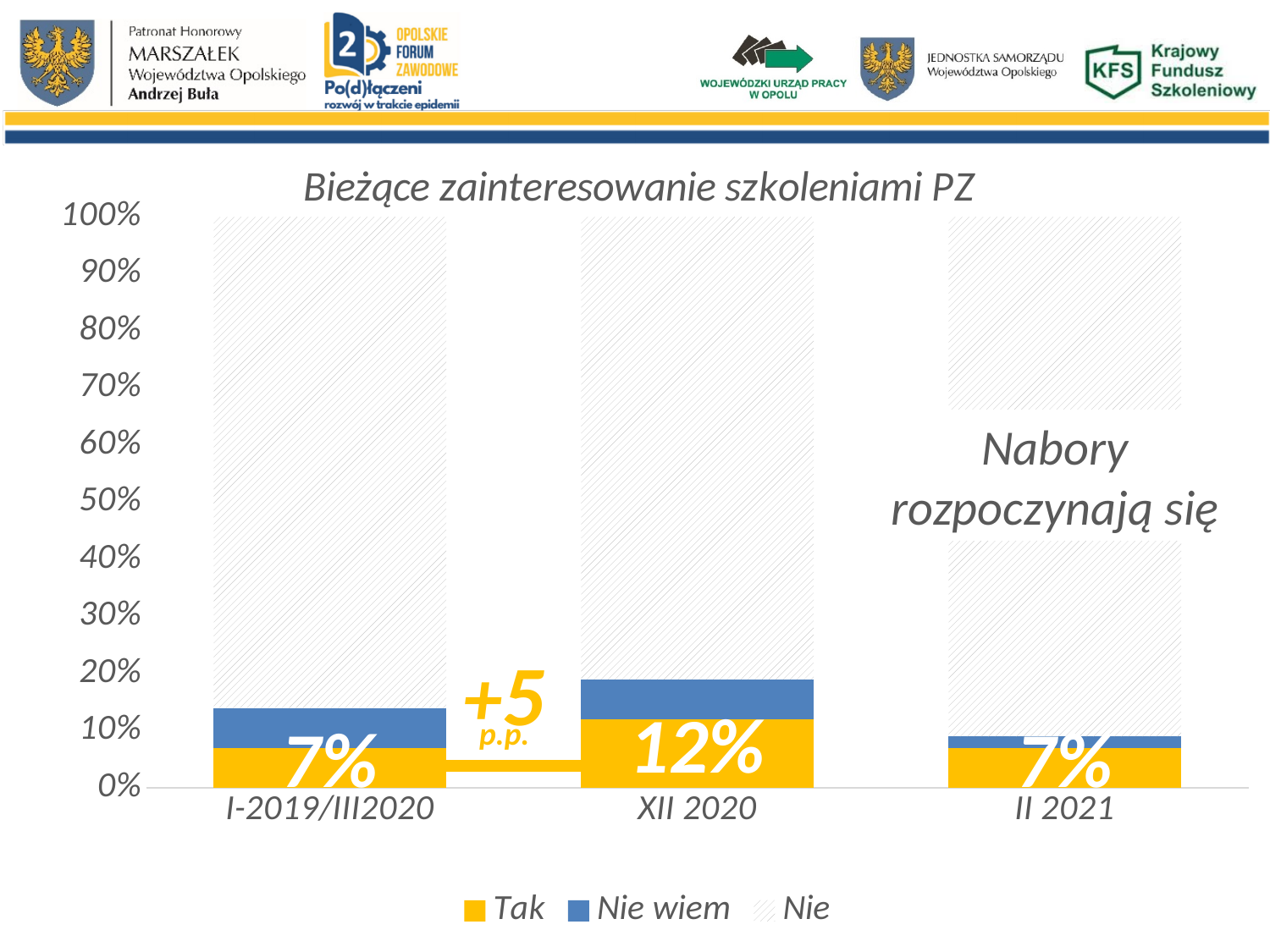
How many series does the legend list? 3 What is the value of the Tak series for I-2019/III2020? 7% What is the title of the chart? Bieżące zainteresowanie szkoleniami PZ What is the value of the Tak series for II 2021? 7% Is the Tak value for II 2021 greater or less than 10%? less Which category has the highest Tak value? XII 2020 What is the value of the Tak series for XII 2020? 12% What kind of chart is shown on the slide? Stacked bar chart By how many percentage points did the Tak value change from I-2019/III2020 to XII 2020? +5 p.p. Which has a larger Tak value, I-2019/III2020 or XII 2020? XII 2020 Is the Tak value for XII 2020 greater or less than 10%? greater How many categories are shown on the x axis? 3